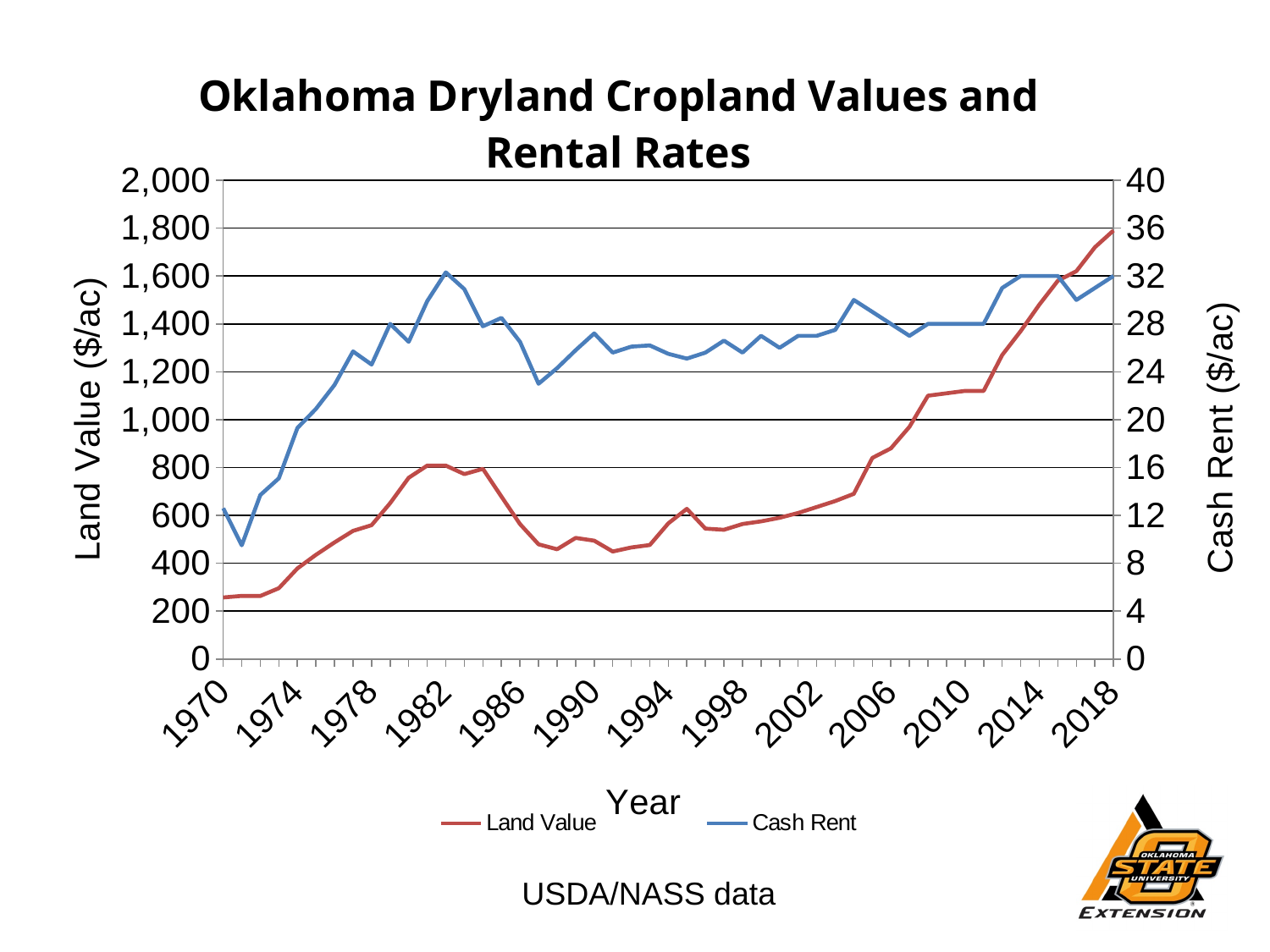
Which is larger, the Land Value in 1982 or the Land Value in 1992? 1982 Does Land Value rise or fall from 1984 to 1992? fall Is the Land Value for 2018 greater or less than 1,600? greater In which year is Cash Rent at its lowest? 1971 How many series does the legend list? 2 Is the Land Value for 1970 greater or less than 400? less In which year is Land Value at its highest? 2018 What is the title of the chart? Oklahoma Dryland Cropland Values and Rental Rates What is the label of the right-hand vertical axis? Cash Rent ($/ac) What kind of chart is shown on the slide? Line chart Does Land Value rise or fall from 2006 to 2018? rise Is the Cash Rent for 1971 greater or less than 12? less